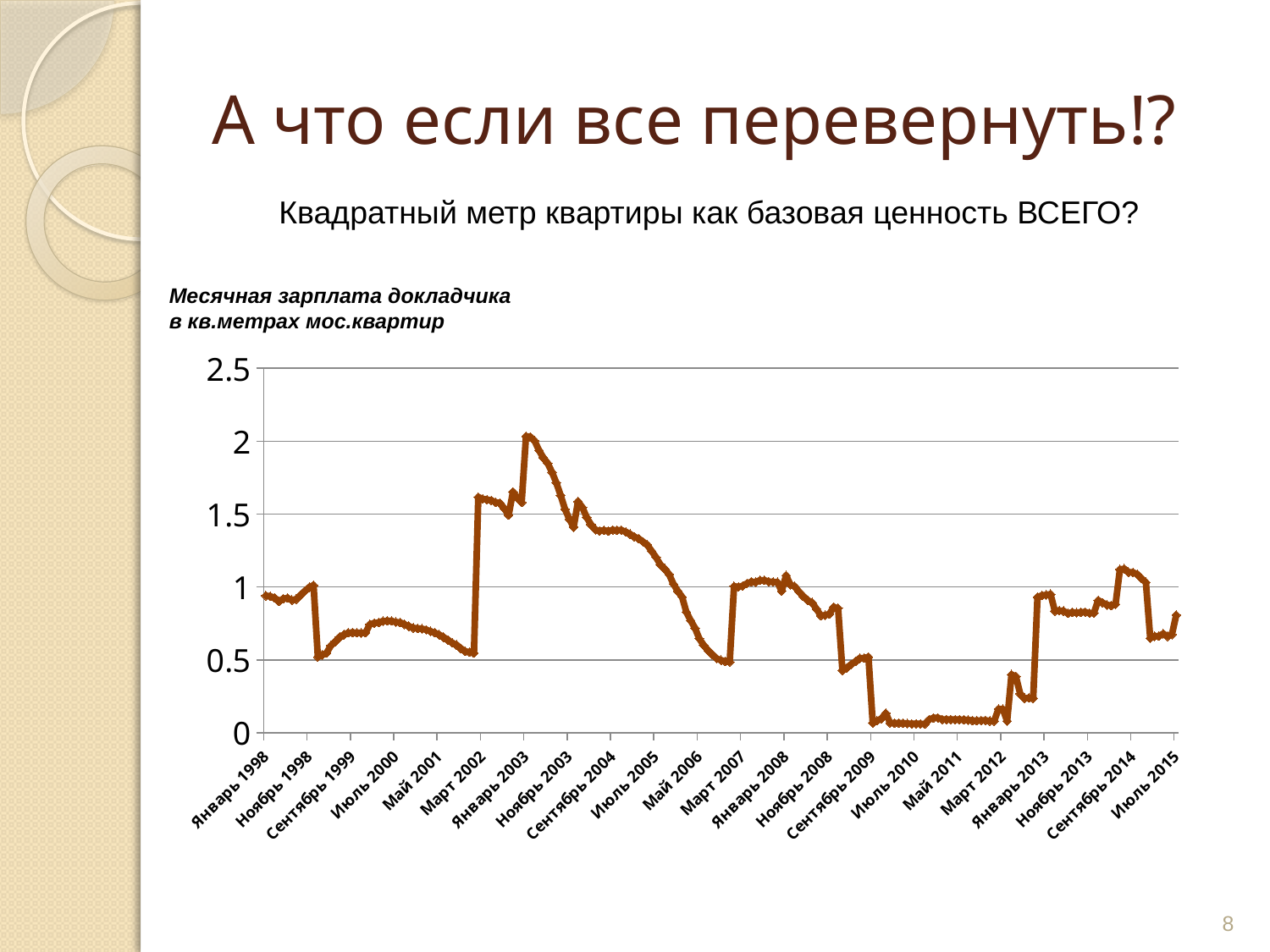
Is the value for Май 2001 greater or less than 1? less What kind of chart is shown on the slide? line chart Is the value for Январь 2003 greater or less than 1.5? greater Is the value for Ноябрь 2003 greater or less than 1? greater Around which labelled date does the line reach its highest value? Январь 2003 What is the title of the chart? Месячная зарплата докладчика в кв.метрах мос.квартир What is the highest value shown on the vertical axis of the chart? 2.5 Between Март 2002 and Январь 2003, does the line rise or fall? rise Between Январь 2003 and Сентябрь 2003, does the line rise or fall? fall